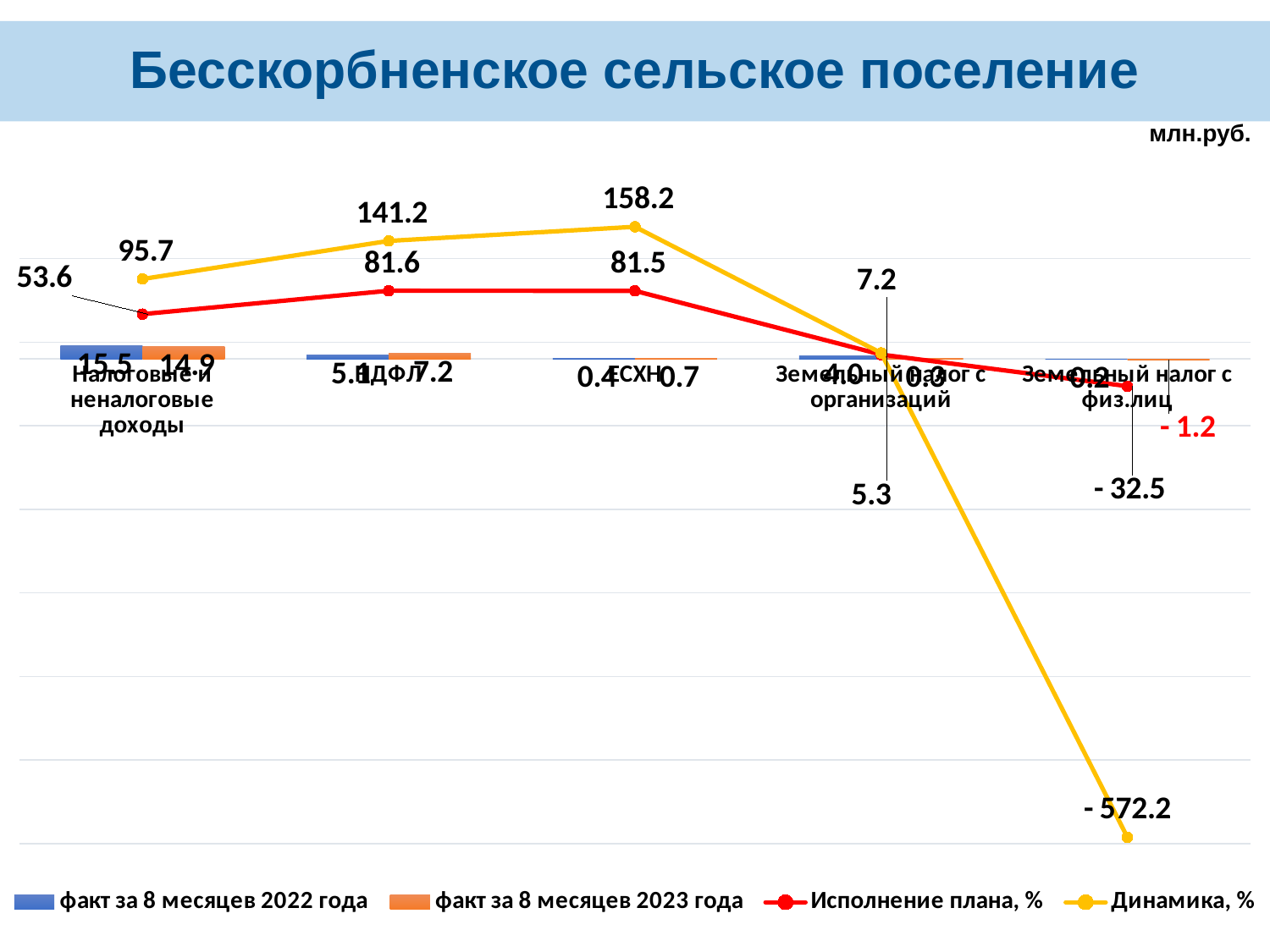
Which category has the highest value of Динамика, %? ЕСХН What is the value of Динамика, % for ЕСХН? 158.2 How many categories are shown along the x axis? 5 Which category has the lowest value of Динамика, %? Земельный налог с физ.лиц What is the value of Исполнение плана, % for Налоговые и неналоговые доходы? 53.6 What is the value of Исполнение плана, % for Земельный налог с физ.лиц? - 32.5 How many series does the legend list? 4 What unit is indicated in the top right corner of the chart? млн.руб. For Налоговые и неналоговые доходы, which is larger: факт за 8 месяцев 2022 года or факт за 8 месяцев 2023 года? факт за 8 месяцев 2022 года What is the value of факт за 8 месяцев 2023 года for НДФЛ? 7.2 What is the difference between факт за 8 месяцев 2023 года and факт за 8 месяцев 2022 года for НДФЛ? 2.1 What kind of chart is shown on the slide? A combined bar and line chart